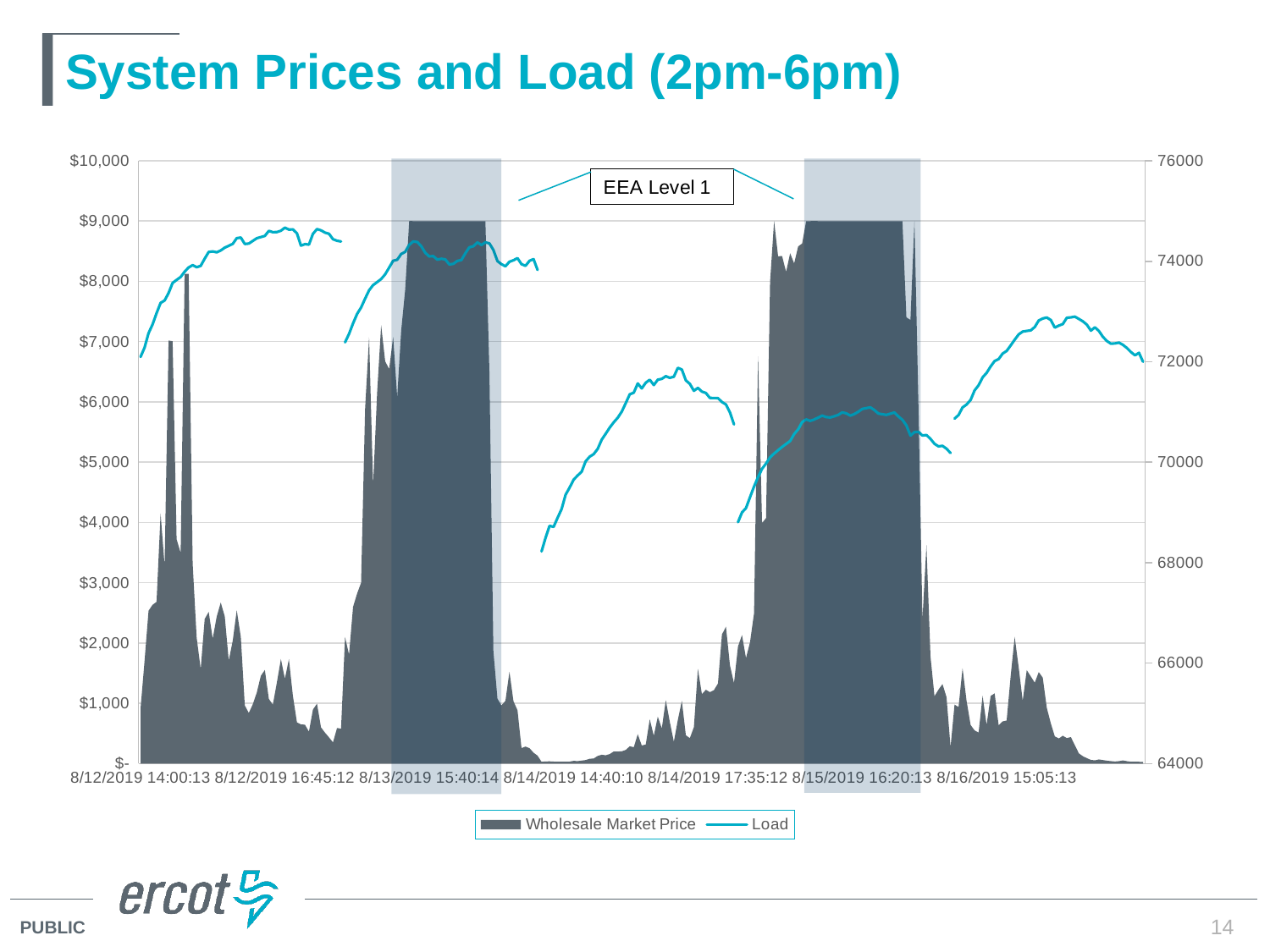
How many date/time labels are shown on the x axis? 7 What kind of chart is used to show the Wholesale Market Price series? Area chart Is the peak Load on 8/16/2019 greater or less than 74000? less Is the Wholesale Market Price at 8/14/2019 14:40:10 greater or less than $1,000? less What kind of chart is used to show the Load series? Line chart Is the peak Wholesale Market Price during the first EEA Level 1 period greater or less than $8,000? greater What is the title of the chart? System Prices and Load (2pm-6pm) What label is shown in the annotation box pointing to the shaded regions? EEA Level 1 What are the two series named in the legend? Wholesale Market Price and Load How many shaded EEA Level 1 regions are marked on the chart? 2 How many series does the legend list? 2